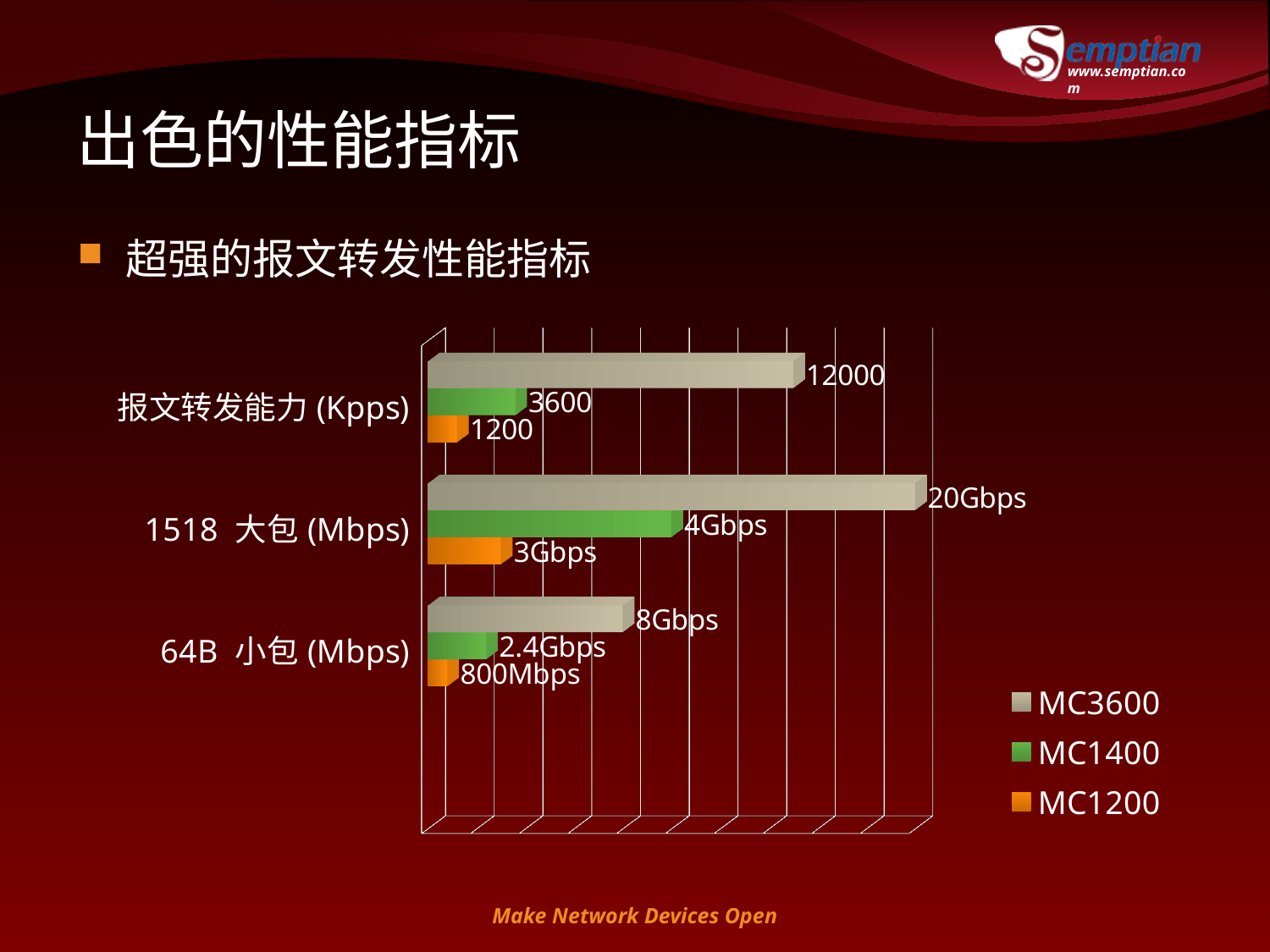
What is the difference between the MC3600 and MC1400 values in the 报文转发能力 (Kpps) category? 8400 What is the value for MC1400 in the 64B 小包 (Mbps) category? 2.4Gbps Which series has the highest value in the 1518 大包 (Mbps) category? MC3600 How many categories are shown on the chart? 3 What is the value for MC1200 in the 64B 小包 (Mbps) category? 800Mbps What kind of chart is shown on the slide? Bar chart Which is larger in the 64B 小包 (Mbps) category: the MC3600 value or the MC1400 value? MC3600 Which series has the lowest value in the 报文转发能力 (Kpps) category? MC1200 What is the value for MC1200 in the 1518 大包 (Mbps) category? 3Gbps What is the value for MC3600 in the 报文转发能力 (Kpps) category? 12000 What is the difference between the MC1400 and MC1200 values in the 1518 大包 (Mbps) category? 1Gbps How many series does the legend list? 3